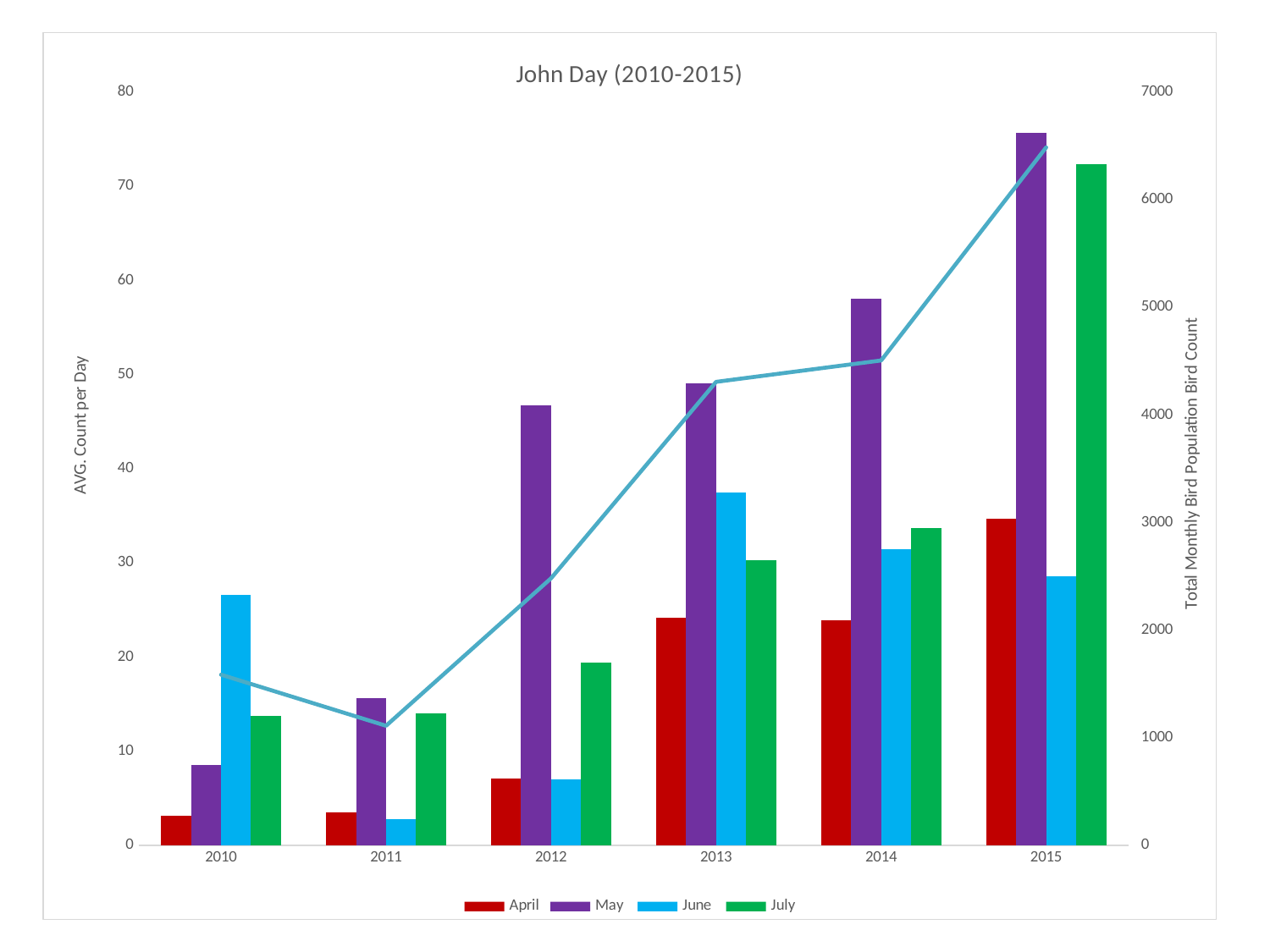
Is the May value for 2015 greater or less than 70? greater In which year is the May bar the highest? 2015 In which year is the April bar the highest? 2015 How many series does the legend list? 4 Is the April value for 2012 greater or less than 10? less What kind of chart is shown on the slide? bar chart with a line How many years are shown on the x axis of the chart? 6 What is the title of the chart? John Day (2010-2015) Is the June value for 2010 greater or less than 20? greater In 2013, which is larger, the June value or the July value? June Do the May bars rise or fall from 2010 to 2015? rise In which year is the June bar the lowest? 2011